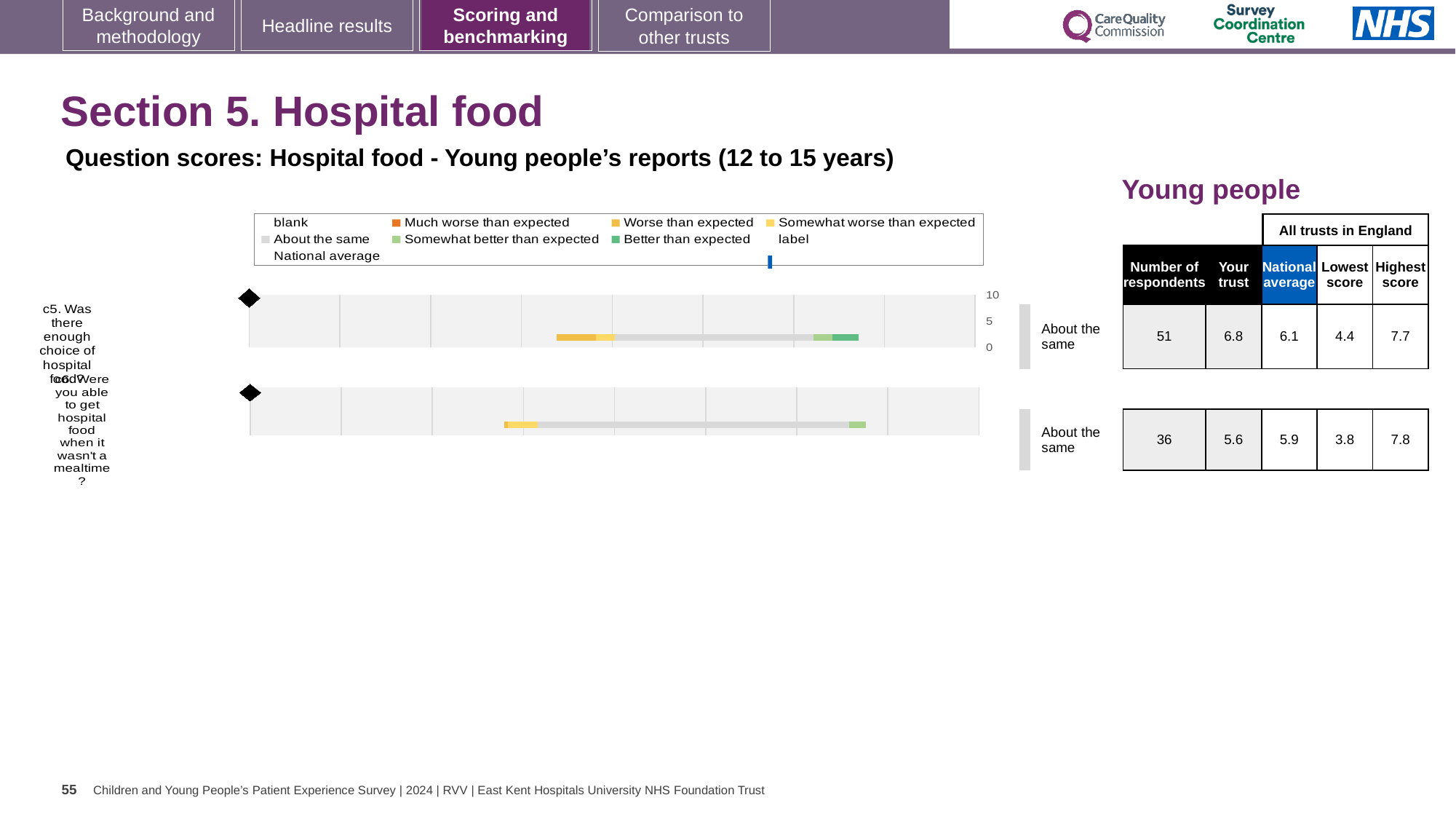
What is the maximum value shown on the chart's score axis? 10 What benchmark rating is shown for question c5 'Was there enough choice of hospital food?' About the same In the Young people table, what is the 'Your trust' score for question c5? 6.8 What kind of chart is used to show the question scores for hospital food? bar chart In the Young people table, what is the national average for question c5? 6.1 Which question has the higher 'Your trust' score, c5 or c6? c5 In the Young people table, how many respondents answered question c6? 36 What colour does the legend use for 'Better than expected'? green How many survey questions are plotted in the hospital food chart? 2 For question c6, is the 'Your trust' score or the national average higher? National average For question c5, what is the difference between the highest score and the lowest score across all trusts in England? 3.3 What benchmark rating is shown for question c6 'Were you able to get hospital food when it wasn't a mealtime?' About the same